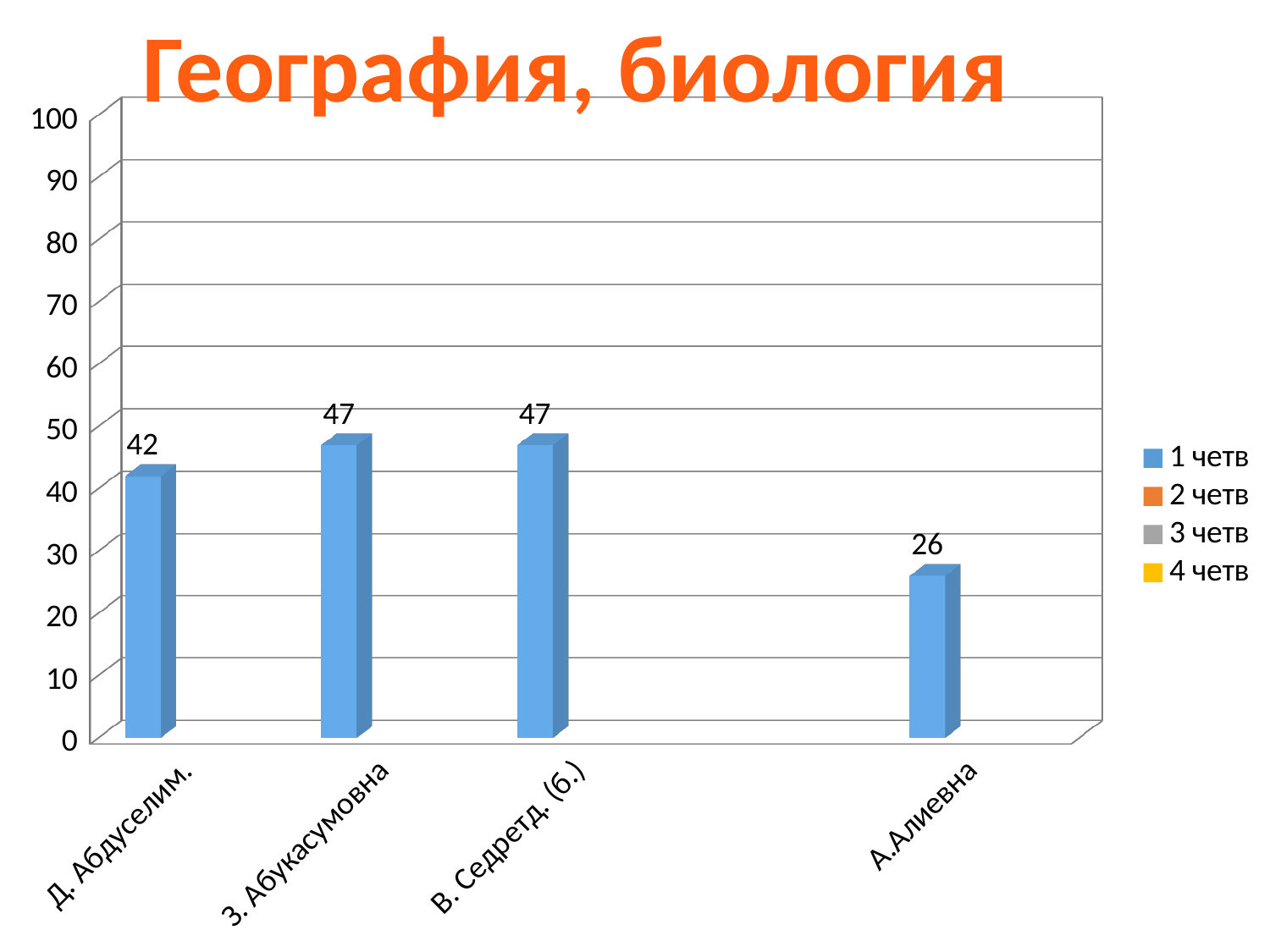
Is the value for А.Алиевна greater or less than 30? less How many categories are shown on the x axis? 4 What is the value for А.Алиевна in the 1 четв series? 26 What is the value for З. Абукасумовна? 47 What is the difference between the values for З. Абукасумовна and А.Алиевна? 21 What is the difference between the values for Д. Абдуселим. and А.Алиевна? 16 What is the value for Д. Абдуселим. in the 1 четв series? 42 Which is larger, the value for Д. Абдуселим. or the value for В. Седретд. (б.)? В. Седретд. (б.) What kind of chart is shown on the slide? bar chart Which category has the lowest value? А.Алиевна How many series does the legend list? 4 What is the title of the chart? География, биология